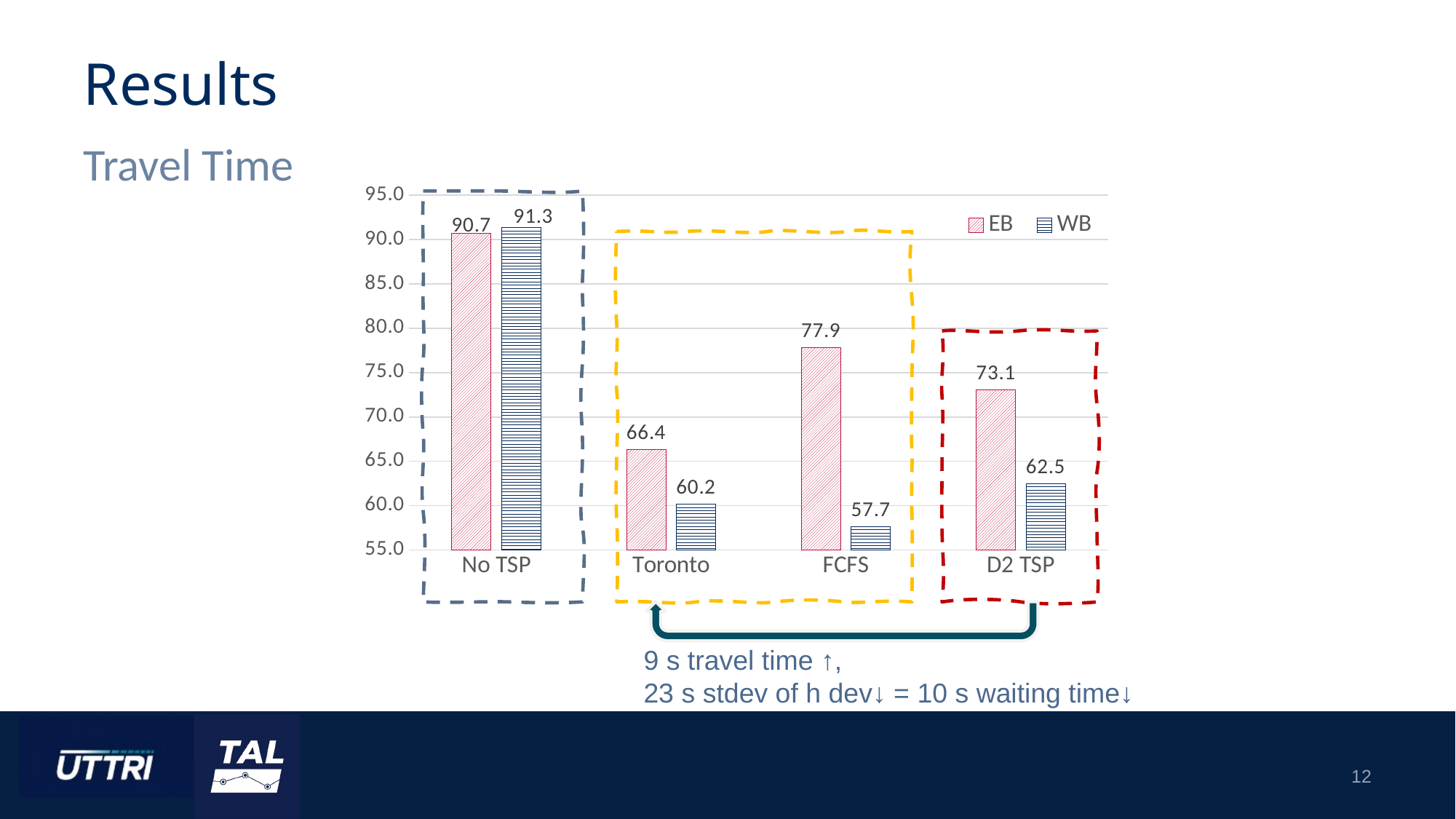
Which is larger, the EB value for D2 TSP or the EB value for FCFS? FCFS Which category has the lowest WB value? FCFS Which category has the highest WB value? No TSP How many series does the legend list? 2 What is the EB value for No TSP? 90.7 What is the EB value for FCFS? 77.9 How many categories are shown on the x axis? 4 What is the difference between the EB and WB values for FCFS? 20.2 What is the WB value for D2 TSP? 62.5 What kind of chart is shown on the slide? Bar chart Which category has the lowest EB value? Toronto What is the WB value for Toronto? 60.2